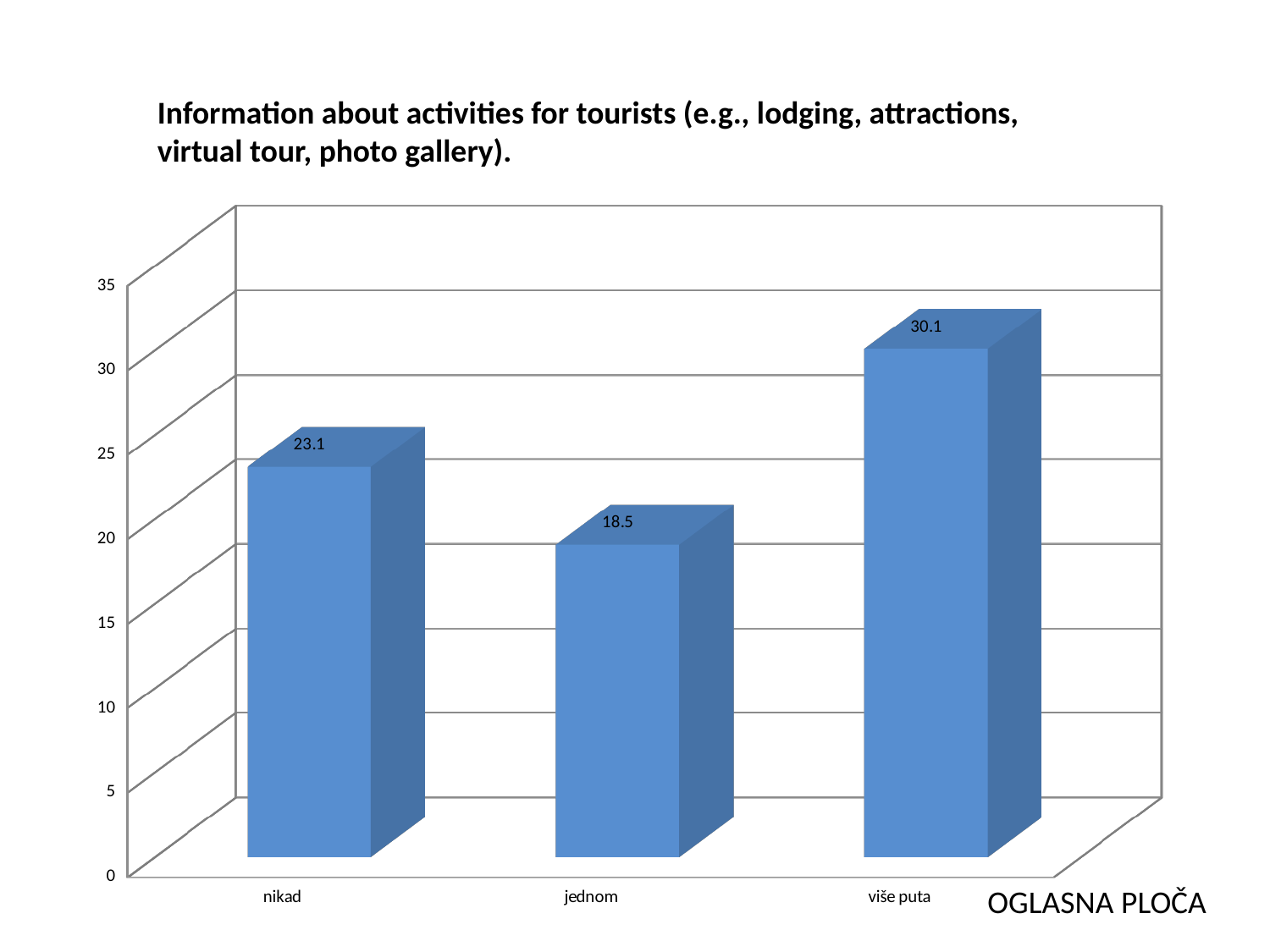
What is the value for "nikad"? 23.1 What is the value for "jednom"? 18.5 What kind of chart is shown on the slide? bar chart Which is larger, the value for "nikad" or the value for "jednom"? nikad Which category has the lowest value? jednom What is the difference between the values for "nikad" and "jednom"? 4.6 How many categories are shown on the x axis? 3 Is the value for "više puta" greater or less than 25? greater Which category has the highest value? više puta What is the difference between the values for "više puta" and "nikad"? 7.0 What is the title of the chart? Information about activities for tourists (e.g., lodging, attractions, virtual tour, photo gallery). What is the value for "više puta"? 30.1